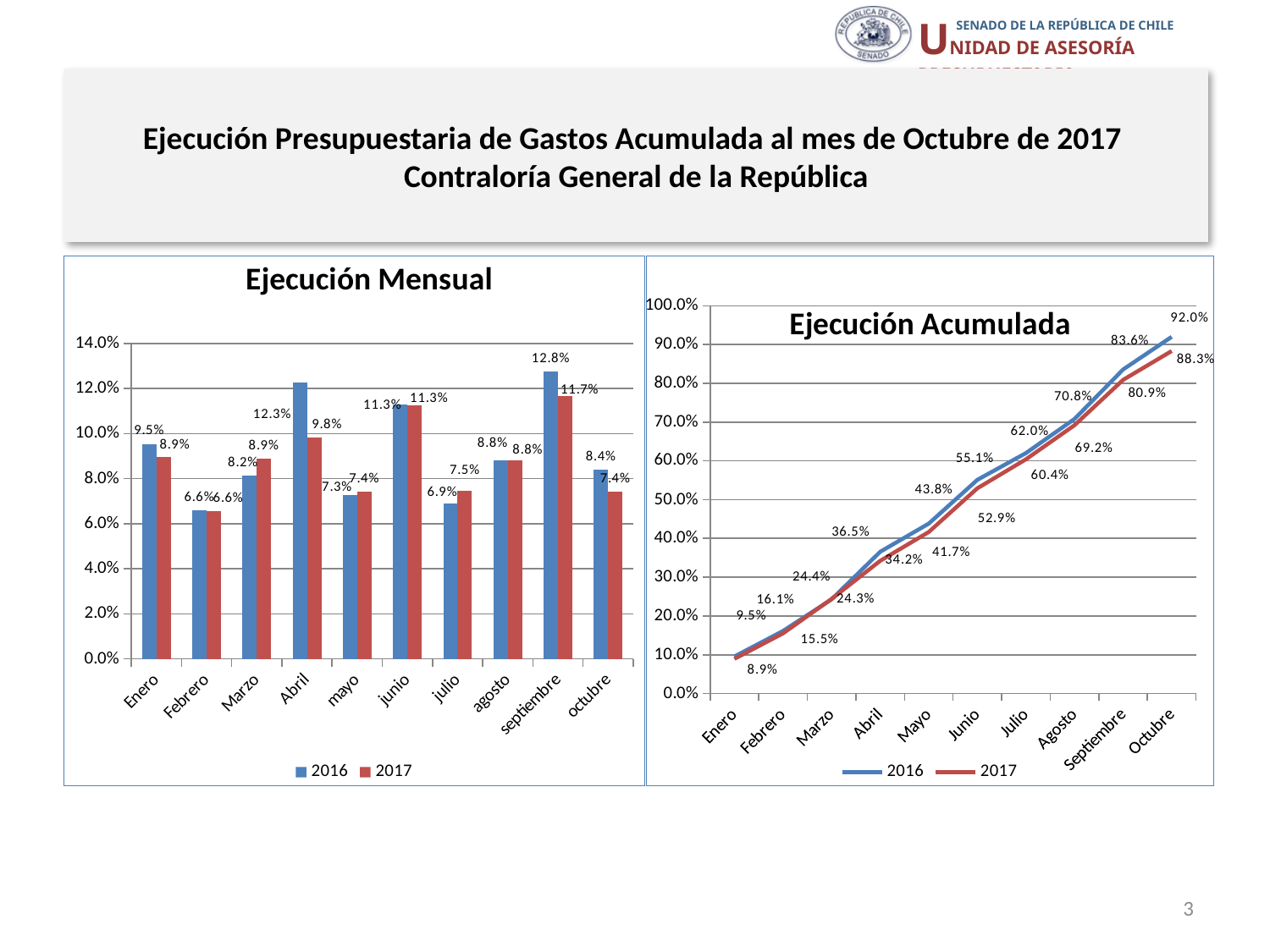
In the 'Ejecución Acumulada' chart, what is the 2017 value for Octubre? 88.3% What type of chart is 'Ejecución Mensual'? Bar chart In the 'Ejecución Mensual' chart, what is the difference between the 2016 and 2017 values for octubre? 1.0% How many series does the legend of the 'Ejecución Acumulada' chart list? 2 In the 'Ejecución Mensual' chart, what is the 2017 value for septiembre? 11.7% In the 'Ejecución Mensual' chart, which is larger for julio: the 2016 value or the 2017 value? 2017 In the 'Ejecución Mensual' chart, what is the 2016 value for Abril? 12.3% In the 'Ejecución Acumulada' chart, what is the difference between the 2016 and 2017 values for Septiembre? 2.7% How many months are shown on the x axis of the 'Ejecución Mensual' chart? 10 In the 'Ejecución Mensual' chart, which month has the lowest 2017 value? Febrero In the 'Ejecución Mensual' chart, which month has the highest 2016 value? septiembre In the 'Ejecución Acumulada' chart, what is the 2016 value for Junio? 55.1%